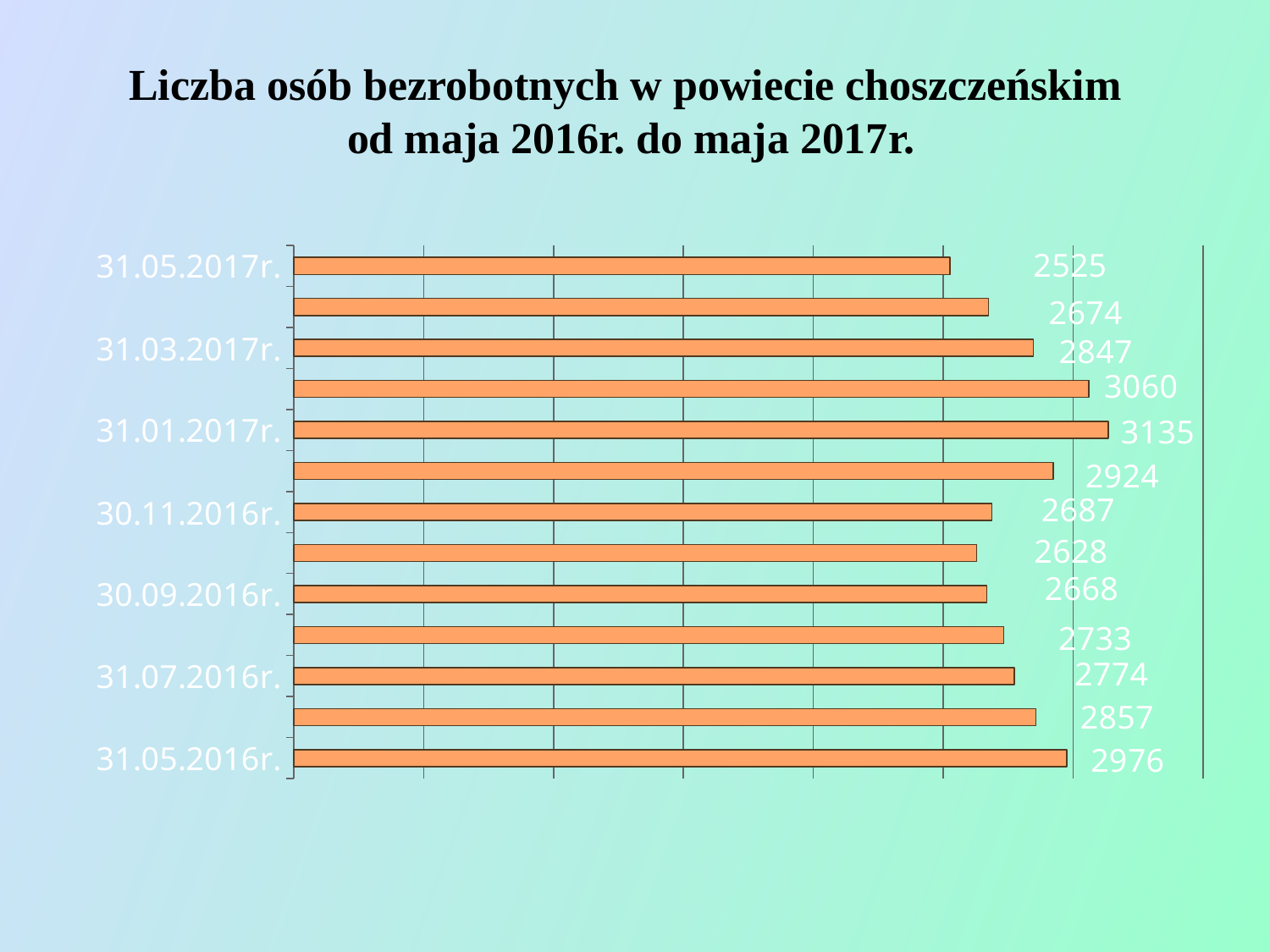
What is the title of the chart? Liczba osób bezrobotnych w powiecie choszczeńskim od maja 2016r. do maja 2017r. How many bars are plotted in the chart? 13 What value is shown for 31.01.2017r.? 3135 Which date has the lowest number of unemployed persons? 31.05.2017r. What is the difference between the values for 31.05.2016r. and 31.05.2017r.? 451 What value is shown for 30.09.2016r.? 2668 What kind of chart is shown on the slide? Bar chart What is the difference between the values for 31.01.2017r. and 31.03.2017r.? 288 Which is larger, the value for 31.07.2016r. or the value for 30.11.2016r.? 31.07.2016r. What value is shown for 31.05.2016r.? 2976 What is the number of unemployed persons shown for 31.05.2017r.? 2525 Which date has the highest number of unemployed persons? 31.01.2017r.